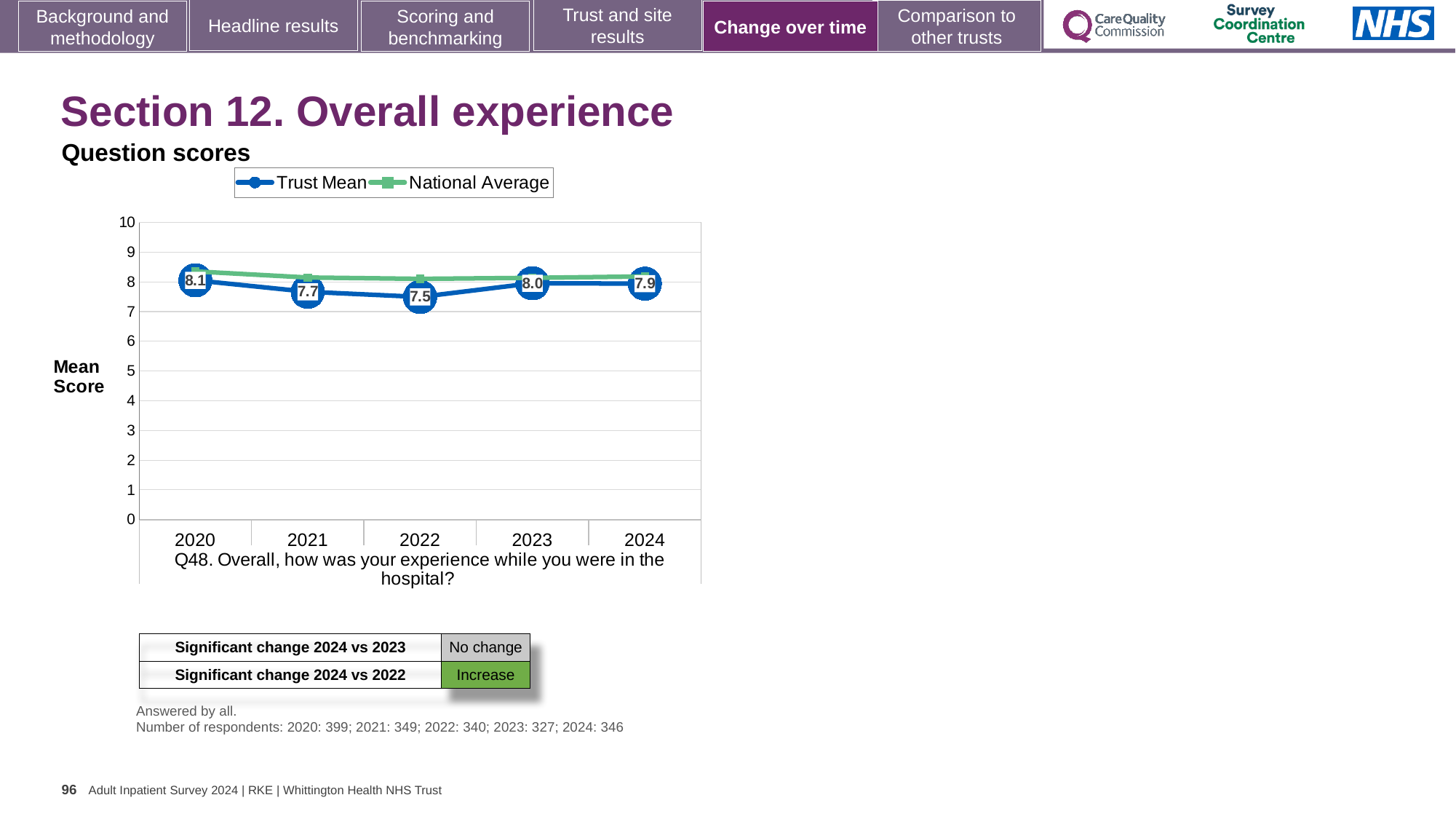
In which year is the Trust Mean highest? 2020 What is the Trust Mean value for 2020? 8.1 How many years are plotted on the x axis? 5 Which is larger, the Trust Mean in 2021 or in 2023? 2023 Does the Trust Mean rise or fall from 2022 to 2023? Rise In which year is the Trust Mean lowest? 2022 Is the National Average value for 2022 greater or less than 7? greater What is the Trust Mean value for 2022? 7.5 What kind of chart is shown on the slide? Line chart What is the Trust Mean value for 2024? 7.9 What is the difference between the Trust Mean in 2020 and in 2022? 0.6 How many series does the legend list? 2